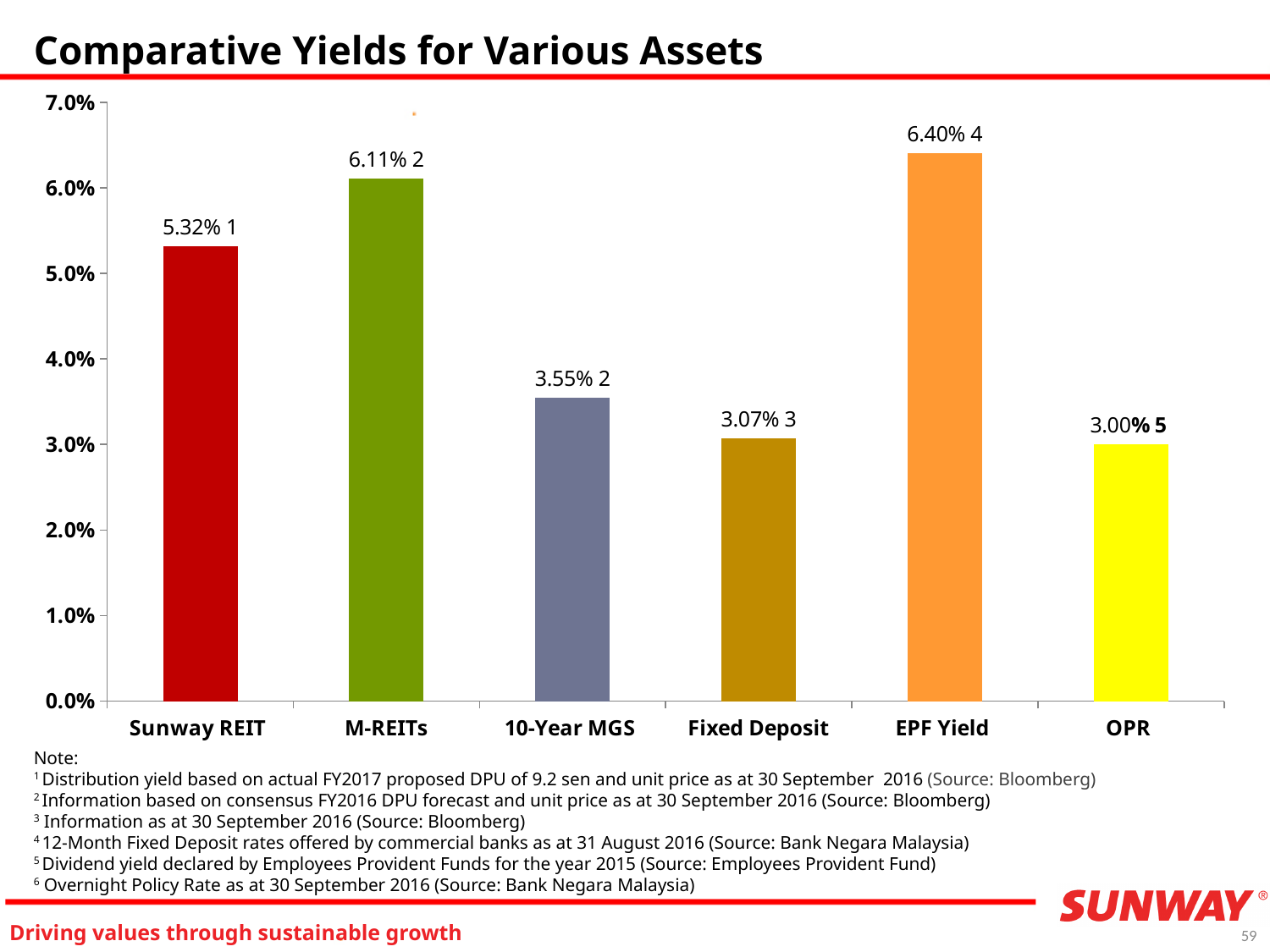
Which asset has the highest yield? EPF Yield What is the yield shown for EPF Yield? 6.40% Which asset has the lowest yield? OPR What is the title of the chart? Comparative Yields for Various Assets Which is larger, the yield for M-REITs or the yield for 10-Year MGS? M-REITs What is the difference between the M-REITs yield and the Sunway REIT yield? 0.79% How many assets are shown on the chart? 6 What is the yield shown for Sunway REIT? 5.32% What is the yield shown for Fixed Deposit? 3.07% What kind of chart is shown on the slide? bar chart Is the value for Fixed Deposit greater or less than 4.0%? less What is the difference between the 10-Year MGS yield and the OPR? 0.55%